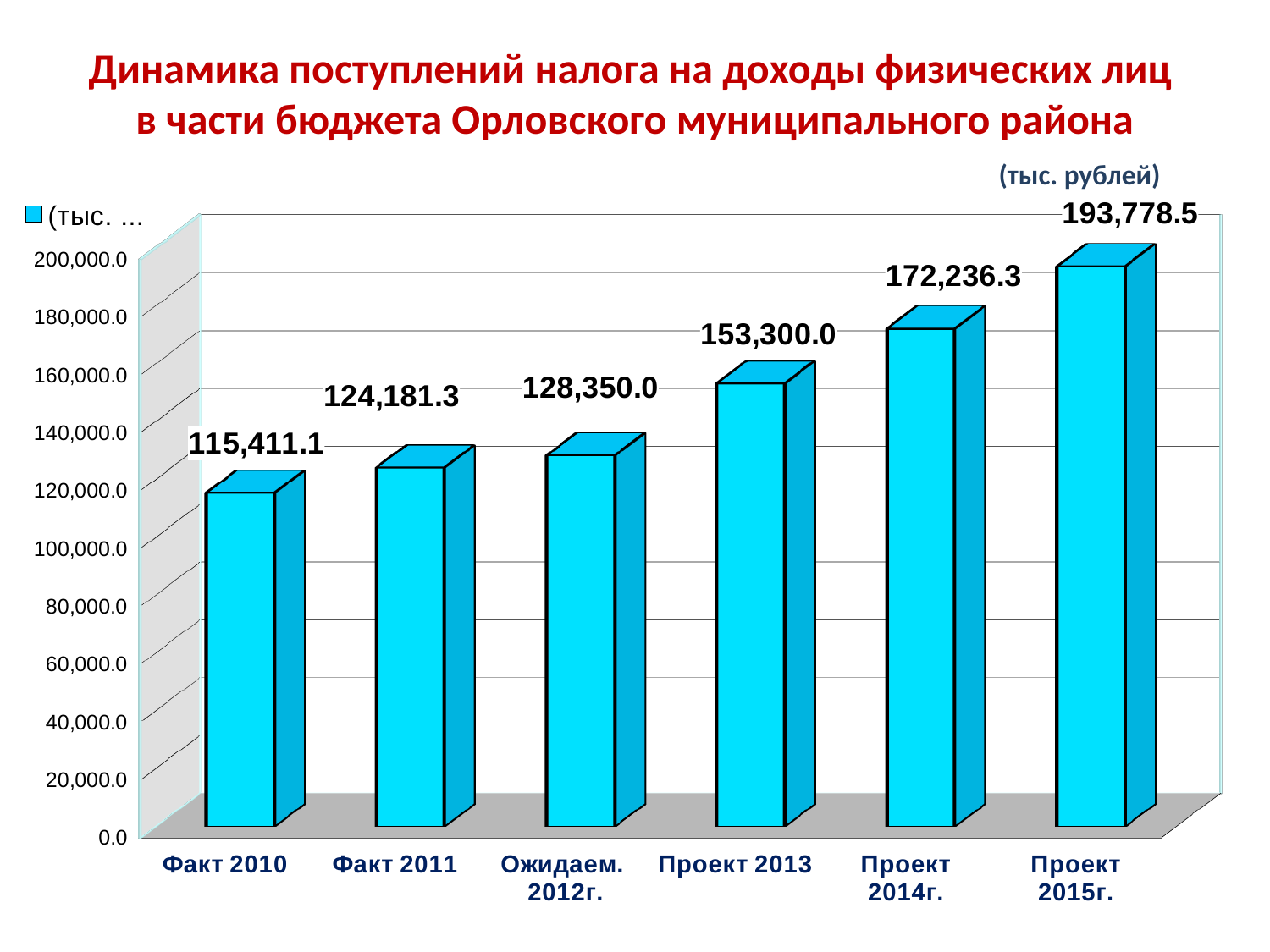
Is the value for Проект 2014г. greater or less than 160,000.0? greater What is the value for Проект 2013? 153,300.0 Do the values rise or fall from Факт 2010 to Проект 2015г.? rise What is the difference between the values for Факт 2011 and Факт 2010? 8,770.2 What is the value for Факт 2010? 115,411.1 What is the difference between the values for Проект 2015г. and Проект 2014г.? 21,542.2 Which category has the lowest value? Факт 2010 How many categories are shown on the x axis? 6 What is the value for Проект 2015г.? 193,778.5 Which is larger, the value for Ожидаем. 2012г. or the value for Факт 2011? Ожидаем. 2012г. Which category has the highest value? Проект 2015г. What kind of chart is shown on the slide? bar chart